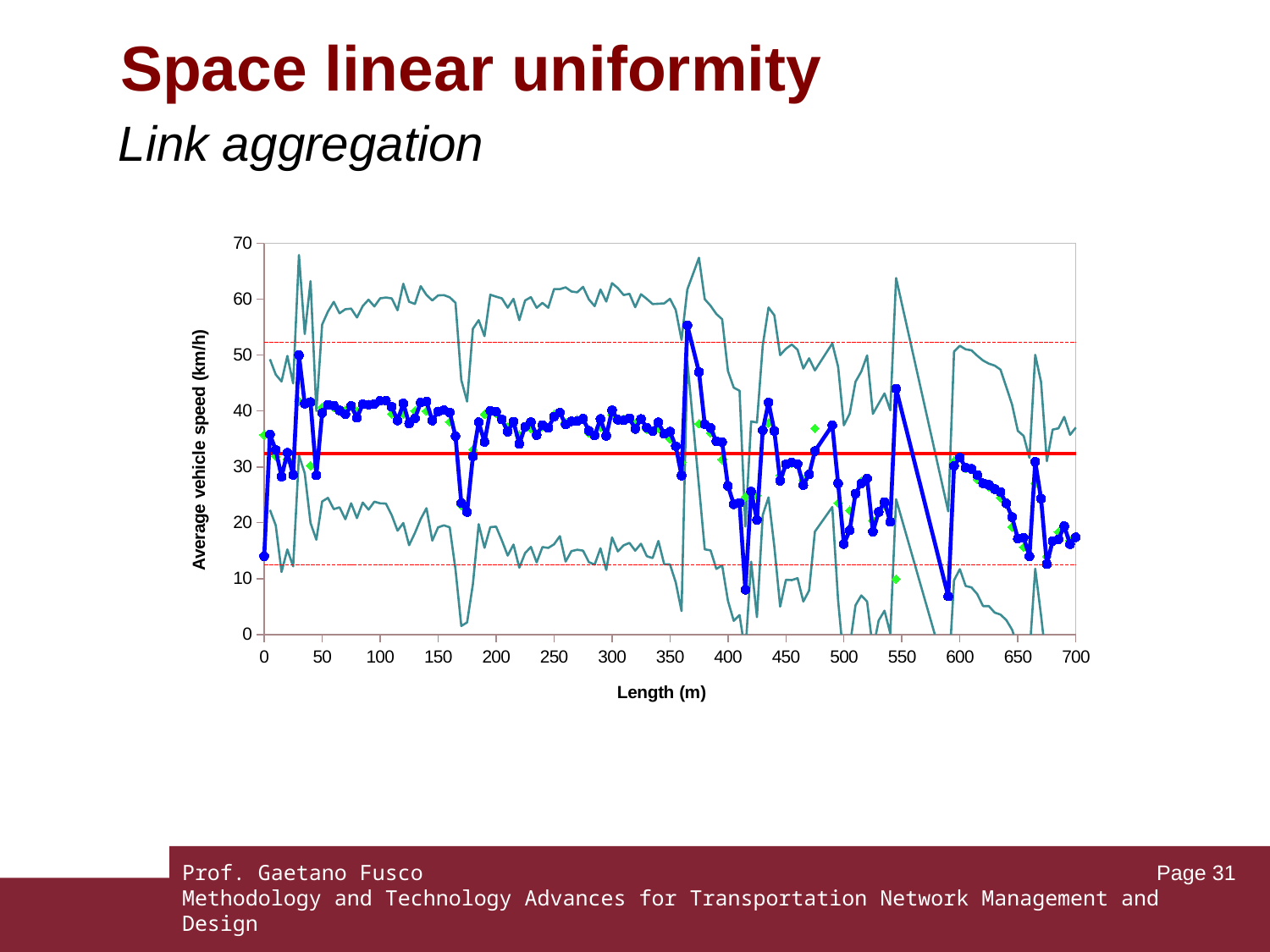
Is the value of the blue line at its dip near Length 590 m greater or less than 10? less What is the highest value shown on the x axis? 700 What kind of chart is shown on the slide? line chart Does the blue line generally rise or fall between Length 600 m and 700 m? fall Is the value of the blue line at Length 0 m greater or less than 20? less Is the dashed black horizontal line greater or less than 20? less What is the label of the y axis of the chart? Average vehicle speed (km/h) What is the label of the x axis of the chart? Length (m)